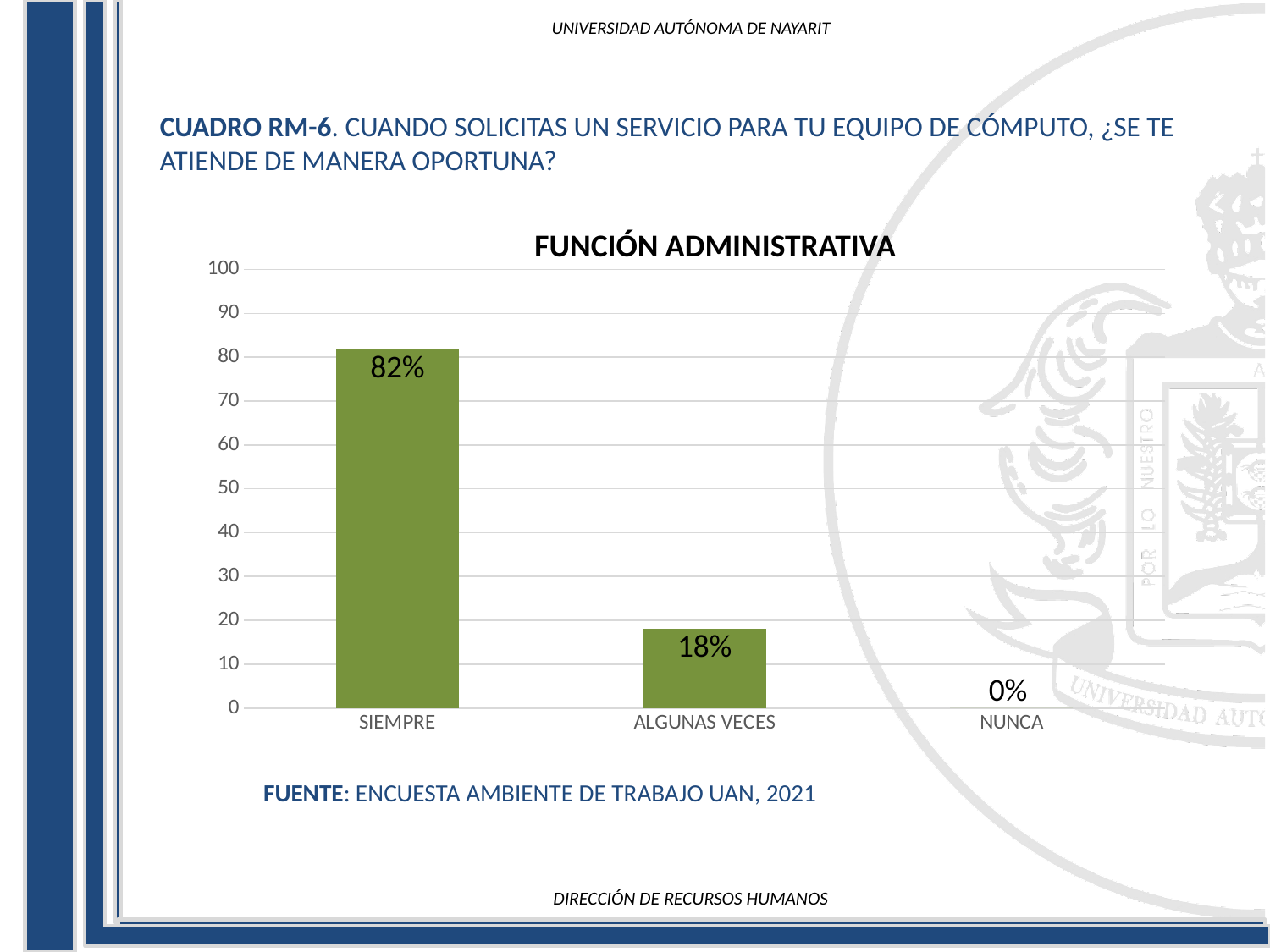
Which category has the lowest value? NUNCA Which is larger, the value for ALGUNAS VECES or the value for NUNCA? ALGUNAS VECES What is the value for ALGUNAS VECES? 18% What is the value for NUNCA? 0% What is the title of the chart? FUNCIÓN ADMINISTRATIVA What kind of chart is shown? bar chart Is the value for SIEMPRE greater or less than 70? greater What is the value for SIEMPRE? 82% What is the difference between the values for SIEMPRE and ALGUNAS VECES? 64% Do the values rise or fall from left to right along the x axis? fall How many categories are shown on the x axis? 3 Which category has the highest value? SIEMPRE